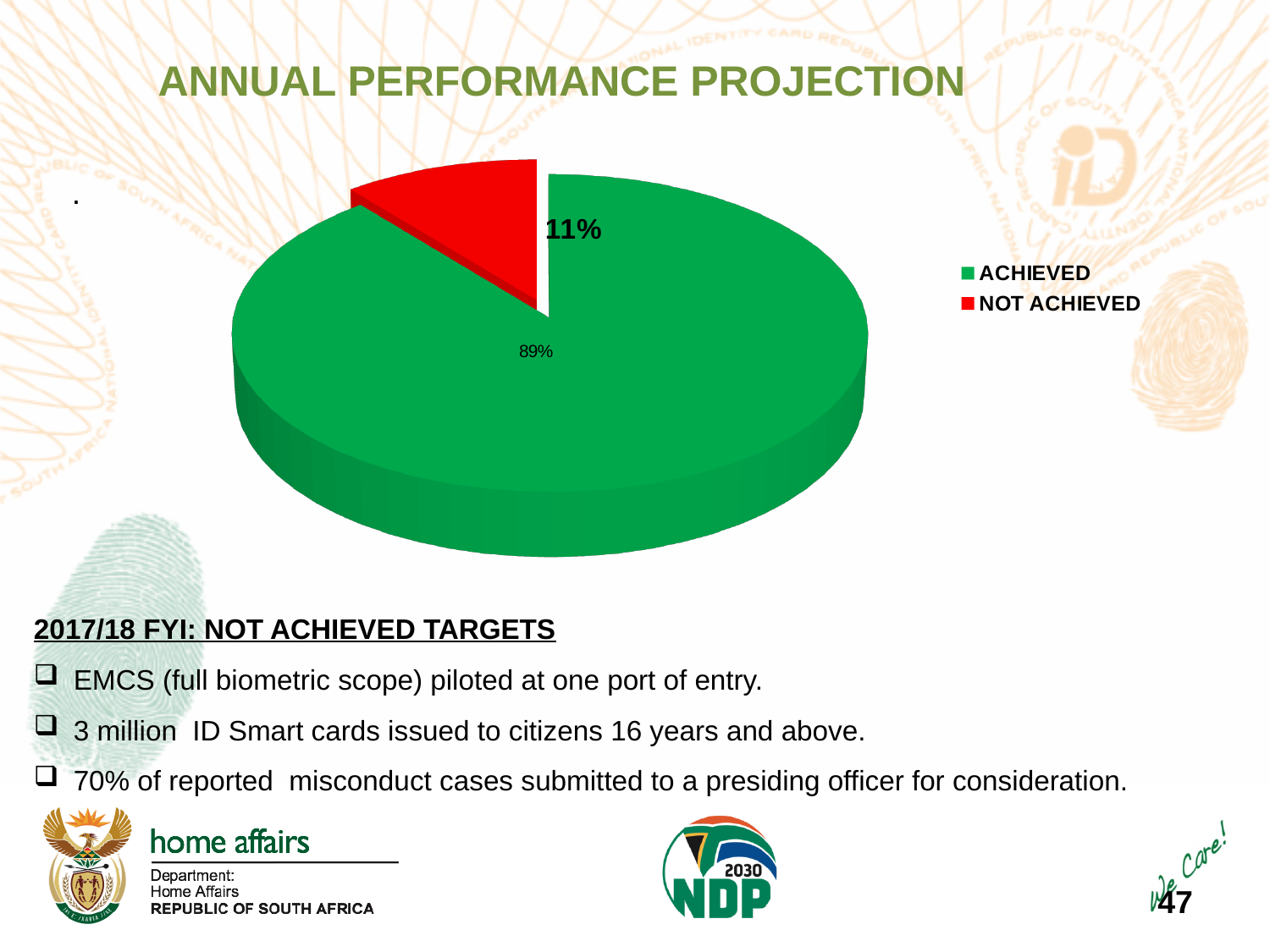
What percentage of the pie chart is labelled ACHIEVED? 89% What share of the pie does the NOT ACHIEVED slice represent? 11% How many entries does the chart legend list? 2 What colour is the ACHIEVED slice in the pie chart? Green What type of chart is shown on the slide? Pie chart What is the title of the slide containing the pie chart? ANNUAL PERFORMANCE PROJECTION Which is larger, the ACHIEVED slice or the NOT ACHIEVED slice? ACHIEVED Which slice of the pie chart is the largest? ACHIEVED Which slice of the pie chart is the smallest? NOT ACHIEVED How many slices does the pie chart have? 2 What percentage of the pie chart is labelled NOT ACHIEVED? 11% What is the difference in percentage points between the ACHIEVED and NOT ACHIEVED slices? 78